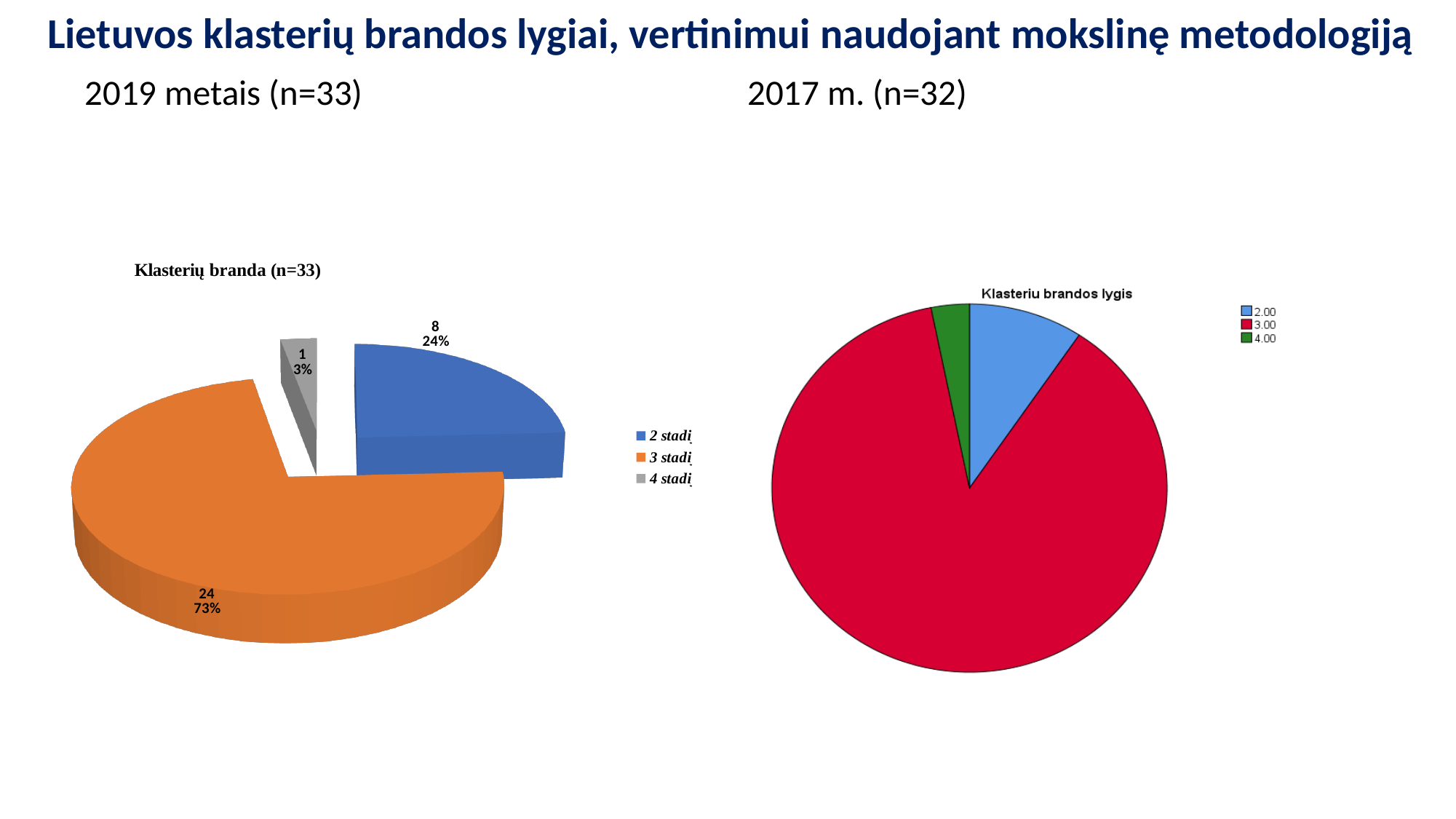
In the left chart titled "Klasterių branda (n=33)", what percentage share does the "3 stadi" slice have? 73% What type of chart is the right chart titled "Klasteriu brandos lygis"? Pie chart In the left chart titled "Klasterių branda (n=33)", what is the difference between the counts for "3 stadi" and "2 stadi"? 16 In the right chart titled "Klasteriu brandos lygis", what colour is the slice for the "4.00" category? Green How many categories does the legend of the left chart titled "Klasterių branda (n=33)" list? 3 In the right chart titled "Klasteriu brandos lygis", which legend category has the largest slice? 3.00 In the left chart titled "Klasterių branda (n=33)", which is larger: the "2 stadi" slice or the "4 stadi" slice? 2 stadi In the left chart titled "Klasterių branda (n=33)", how many clusters are in the "3 stadi" category? 24 In the left chart titled "Klasterių branda (n=33)", which category has the largest slice? 3 stadi In the left chart titled "Klasterių branda (n=33)", what is the count for "4 stadi"? 1 In the left chart titled "Klasterių branda (n=33)", which category has the smallest slice? 4 stadi In the left chart titled "Klasterių branda (n=33)", what percentage share does the "2 stadi" slice have? 24%